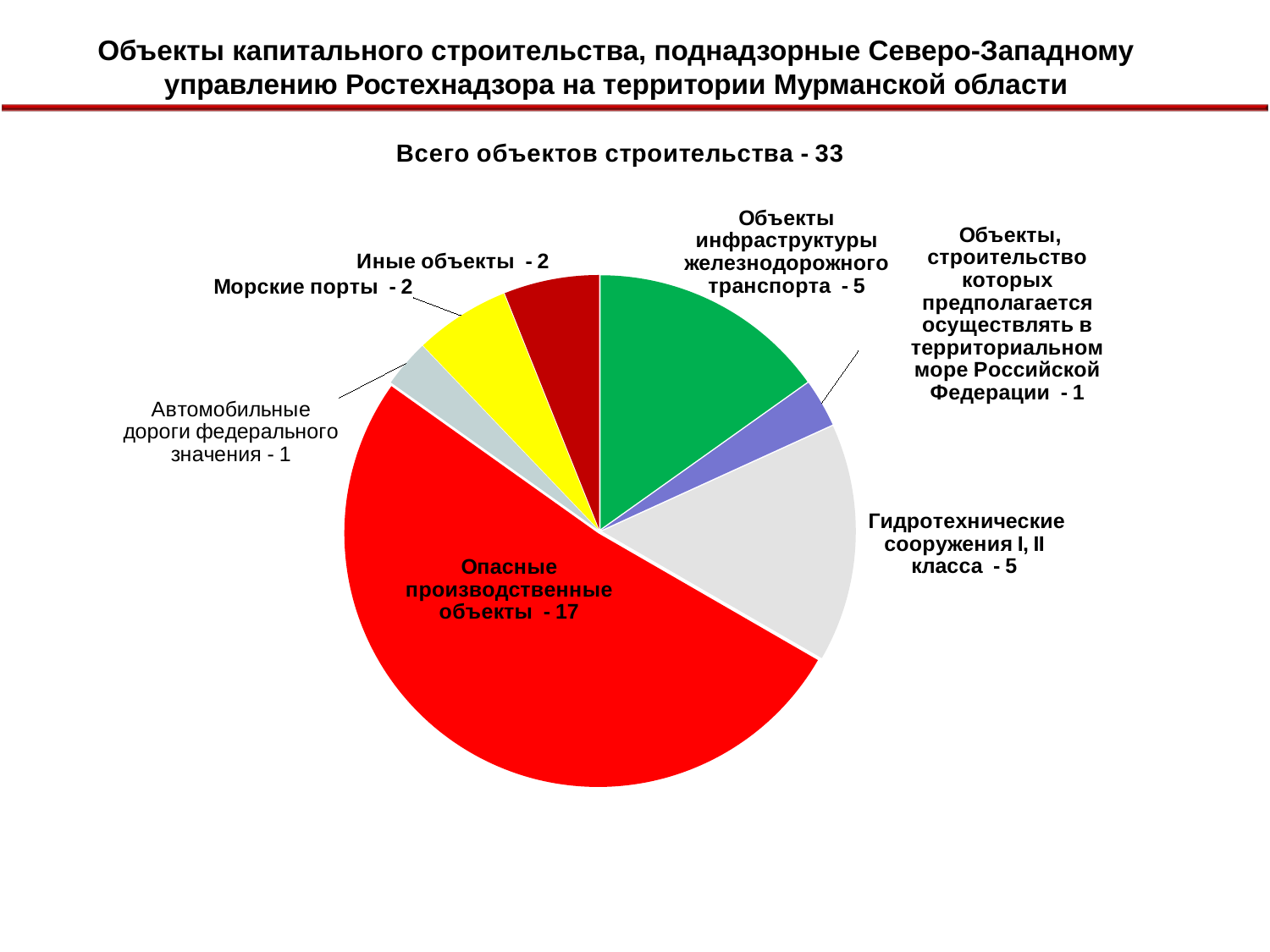
What type of chart is shown on the slide? Pie chart How many objects are in the category «Морские порты»? 2 Which is larger: «Иные объекты» or «Автомобильные дороги федерального значения»? Иные объекты How many objects are in the category «Автомобильные дороги федерального значения»? 1 Which category has the largest slice of the pie? Опасные производственные объекты How many objects are in the category «Опасные производственные объекты»? 17 What colour is the slice for «Опасные производственные объекты»? Red How many objects are in the category «Гидротехнические сооружения I, II класса»? 5 How many categories (slices) does the pie chart have? 7 How many objects are in the category «Объекты инфраструктуры железнодорожного транспорта»? 5 What is the difference between «Опасные производственные объекты» and «Гидротехнические сооружения I, II класса»? 12 What is the total number of construction objects stated on the slide? 33